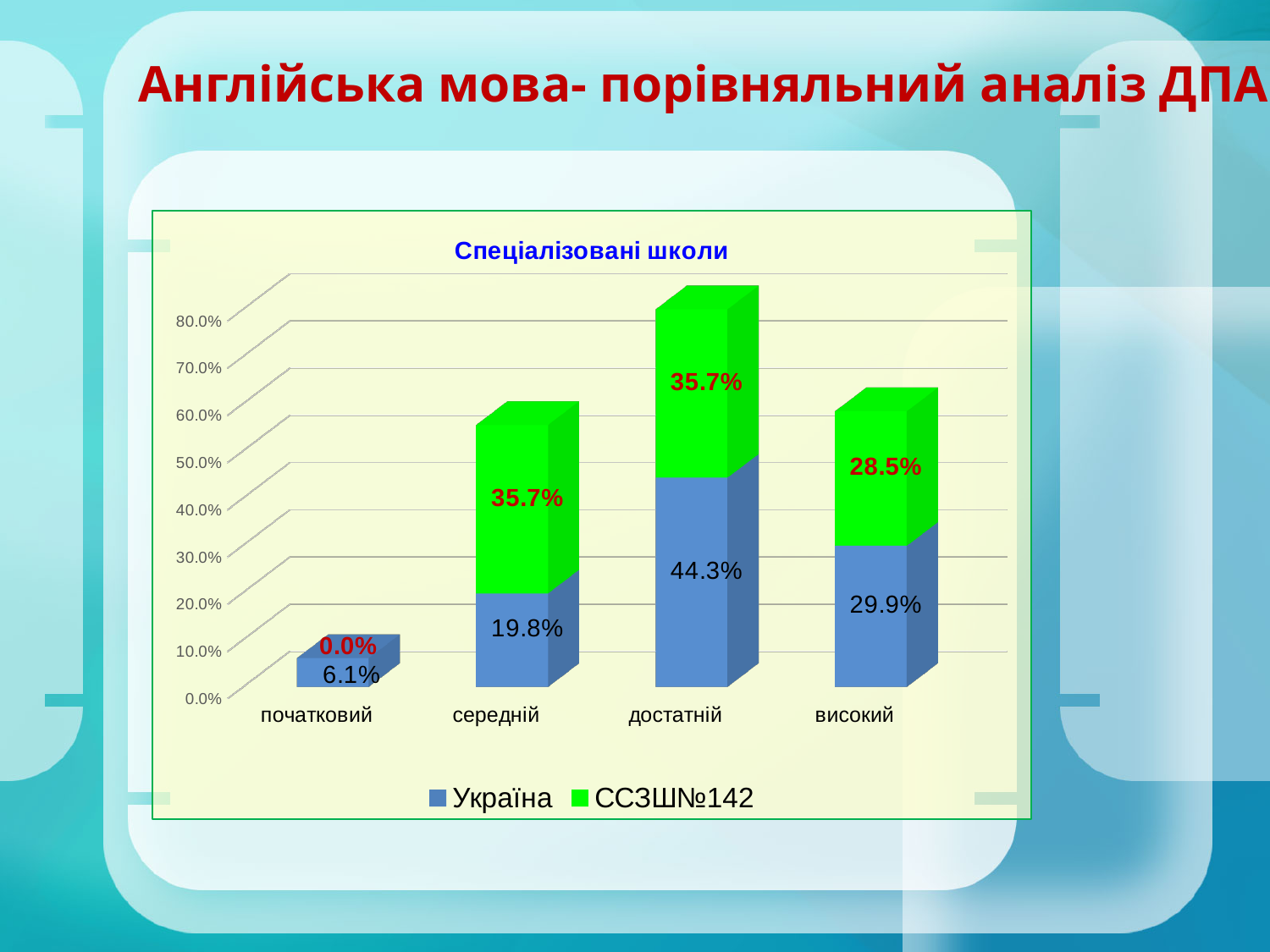
Which category has the highest value for Україна? достатній Which category has the lowest value for Україна? початковий How many categories are shown on the x axis? 4 What is the value for ССЗШ№142 in the початковий category? 0.0% What is the difference between the Україна values for достатній and високий? 14.4% What is the title of the chart? Спеціалізовані школи What kind of chart is shown on the slide? stacked bar chart How many series does the legend list? 2 What is the value for Україна in the достатній category? 44.3% Which is larger in the середній category: the value for Україна or for ССЗШ№142? ССЗШ№142 What is the total of the stacked bar for the середній category? 55.5% What is the value for ССЗШ№142 in the високий category? 28.5%